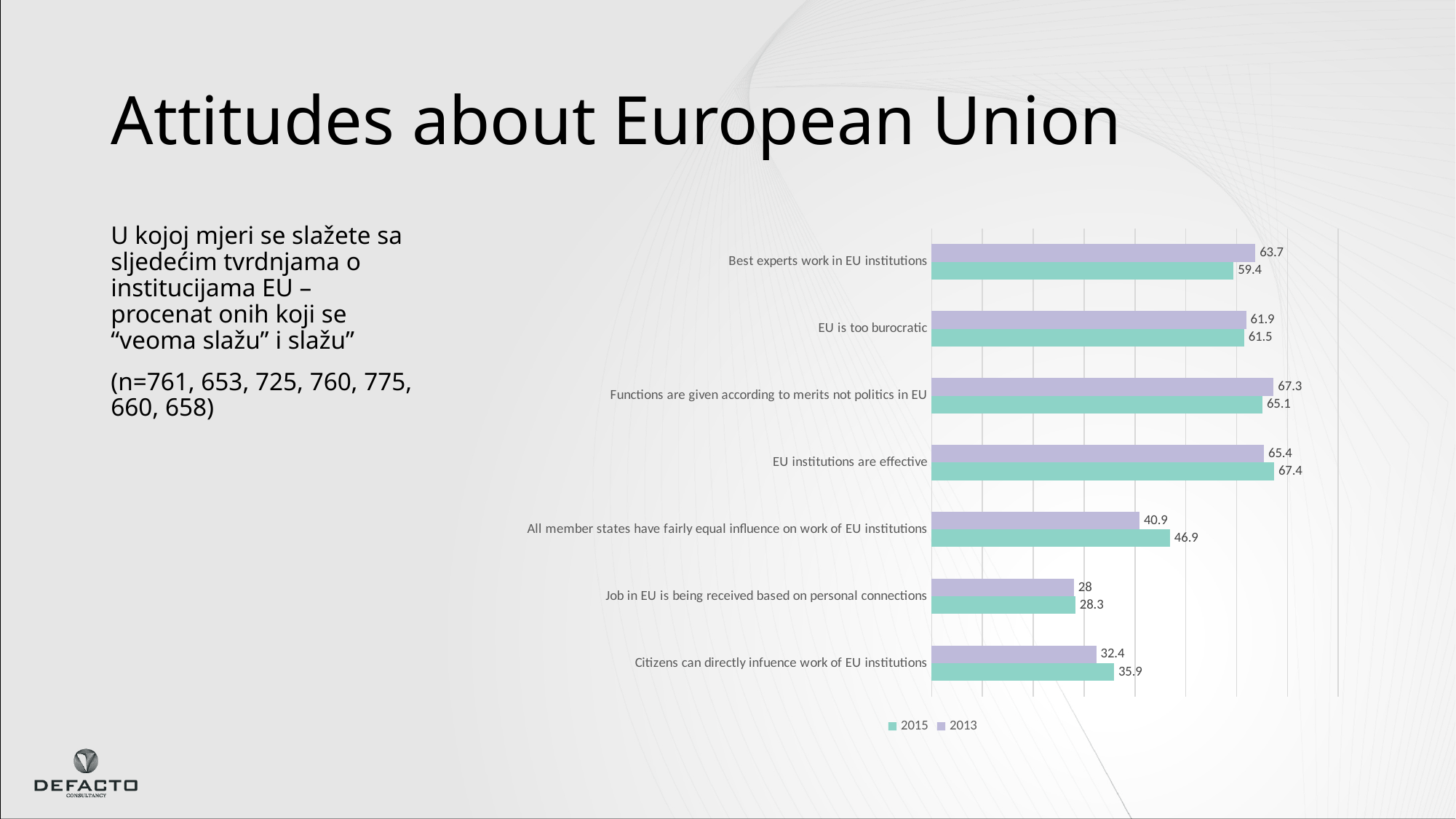
By how much did the value for "All member states have fairly equal influence on work of EU institutions" change from 2013 to 2015? 6 What is the 2015 value for "EU institutions are effective"? 67.4 Which colour represents the 2015 series in the chart? Teal (green) What type of chart is shown on the slide? Bar chart Which statement has the highest 2015 value? EU institutions are effective What is the 2013 value for "All member states have fairly equal influence on work of EU institutions"? 40.9 What is the 2015 value for "Citizens can directly infuence work of EU institutions"? 35.9 How many series does the legend list? 2 For "Best experts work in EU institutions", which year has the larger value, 2013 or 2015? 2013 What is the difference between the 2013 and 2015 values for "Best experts work in EU institutions"? 4.3 Which statement has the lowest 2013 value? Job in EU is being received based on personal connections How many statements (categories) are shown in the chart? 7